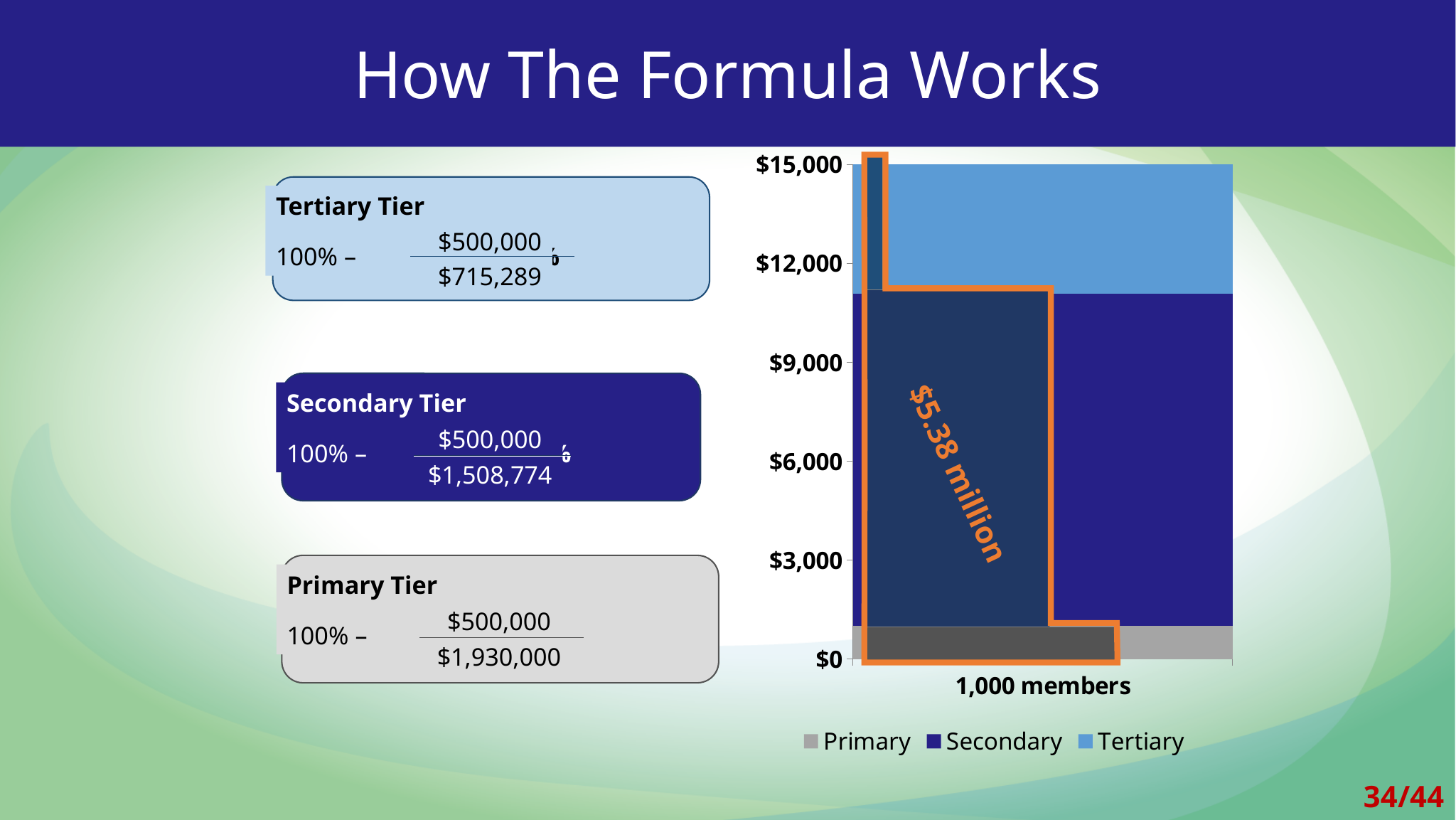
Which segment is larger in the stacked bar, Secondary or Tertiary? Secondary Which series forms the smallest segment of the stacked bar? Primary How many categories are plotted on the x axis of the chart? 1 How many series does the chart legend list? 3 Is the Secondary segment of the bar greater or less than $9,000? greater Is the Primary segment of the bar greater or less than $3,000? less What is the label of the single category on the x axis of the chart? 1,000 members Which series forms the largest segment of the stacked bar? Secondary Is the Tertiary segment of the bar greater or less than $6,000? less What kind of chart is shown on the slide? Stacked bar chart What are the three series named in the chart legend? Primary, Secondary, Tertiary